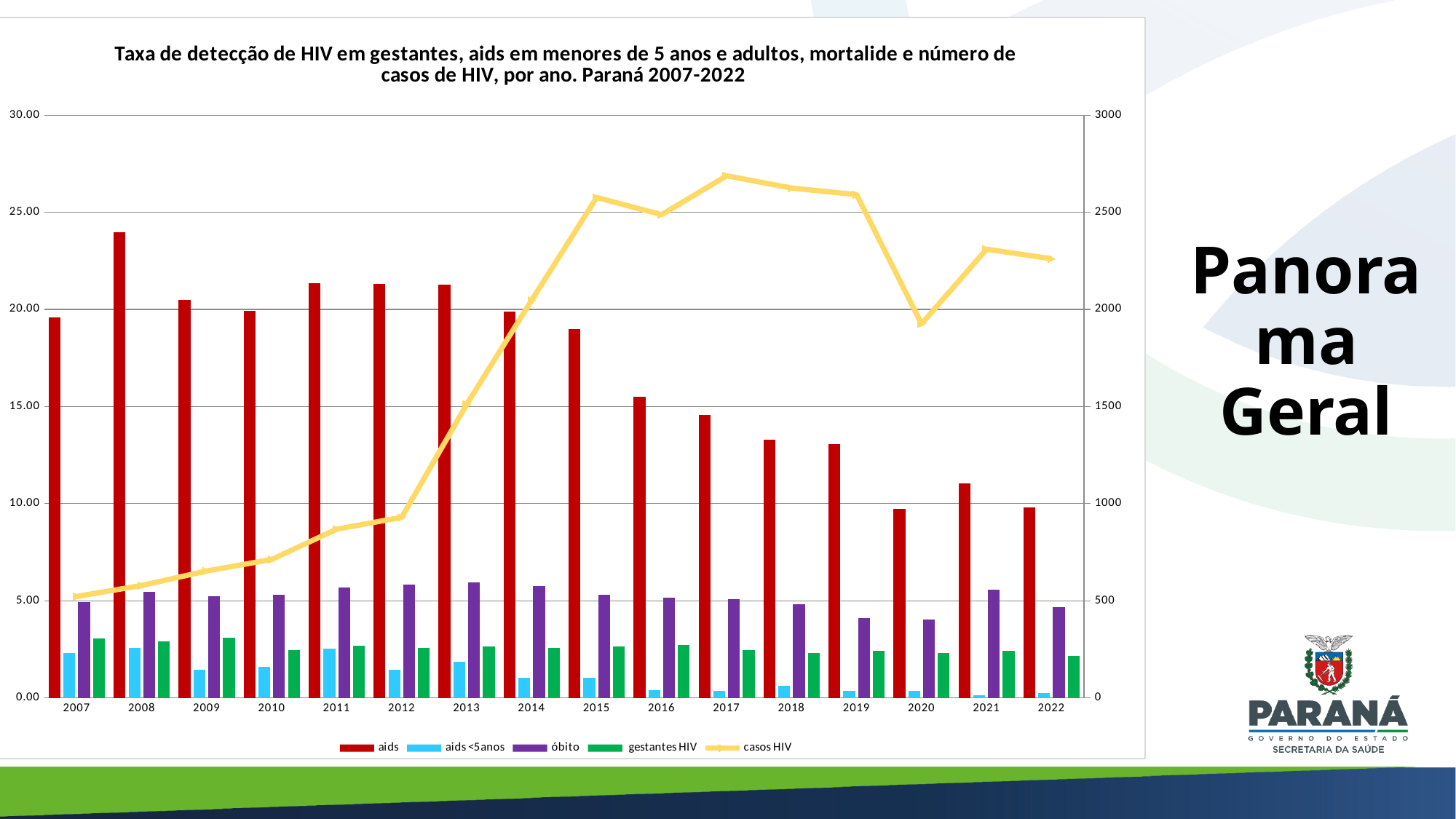
What kind of chart is shown on the slide? A combined bar and line chart In which year is the casos HIV line at its highest point? 2017 Is the aids value for 2018 greater or less than 10.00? greater Which is larger, the óbito value for 2013 or for 2019? 2013 Is the casos HIV value for 2012 greater or less than 1000? less In which year is the aids bar highest? 2008 Is the casos HIV value for 2020 greater or less than 2000? less In which year is the casos HIV line at its lowest point? 2007 How many series does the legend list? 5 How many years are shown on the x axis? 16 Does the casos HIV line rise or fall from 2007 to 2017? rise